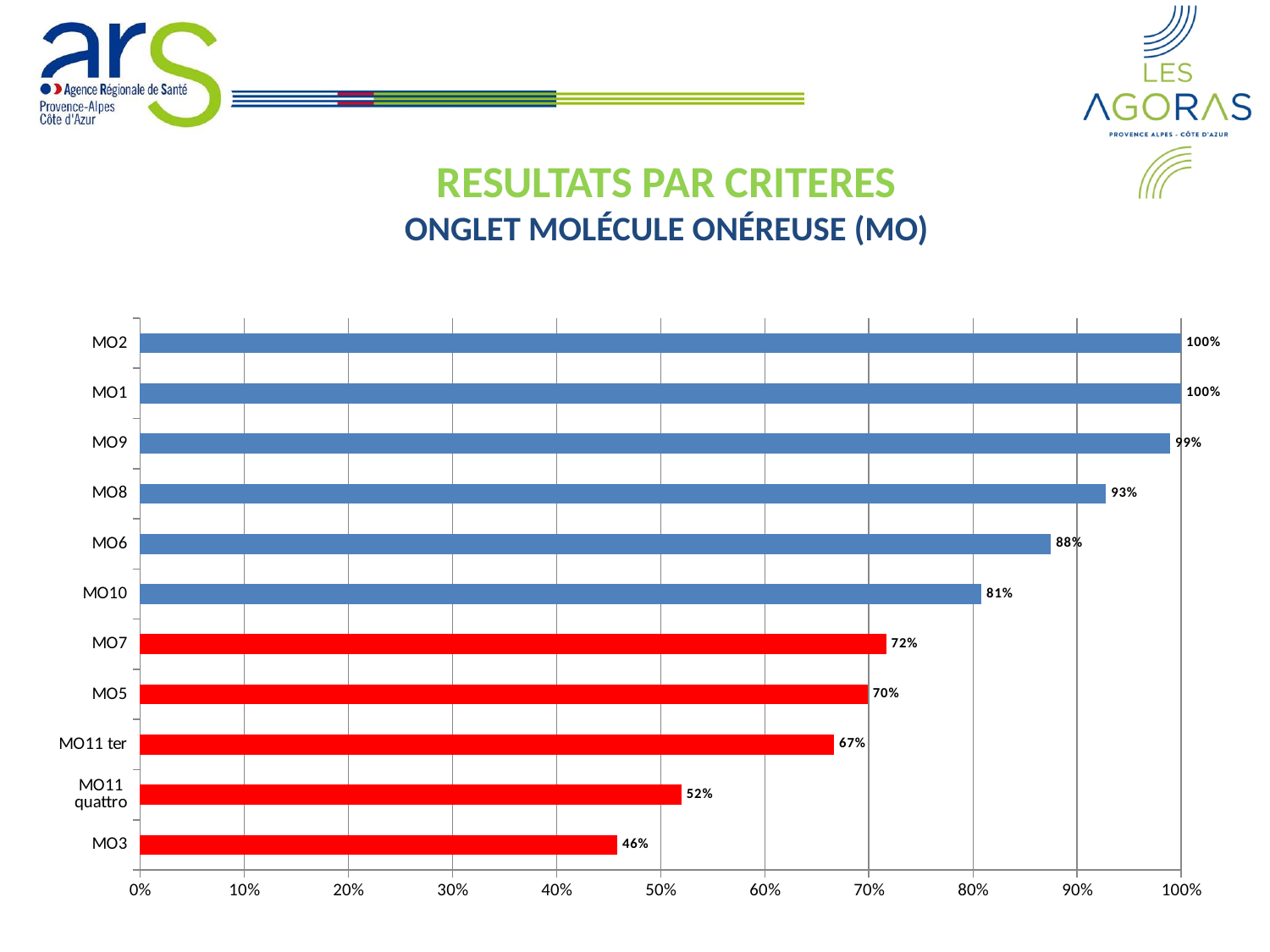
What is the value for MO8? 93% What colour are the bars for MO7, MO5, MO11 ter, MO11 quattro and MO3? red What is the difference between the values for MO7 and MO11 ter? 5% Which is larger, the value for MO5 or the value for MO9? MO9 How many categories share the highest value of 100%? 2 How many categories are shown on the chart? 11 What is the value for MO11 quattro? 52% Which category has the lowest value? MO3 What is the difference between the values for MO6 and MO3? 42% What kind of chart is shown on the slide? bar chart Is the value for MO11 ter greater or less than 60%? greater What is the value for MO10? 81%